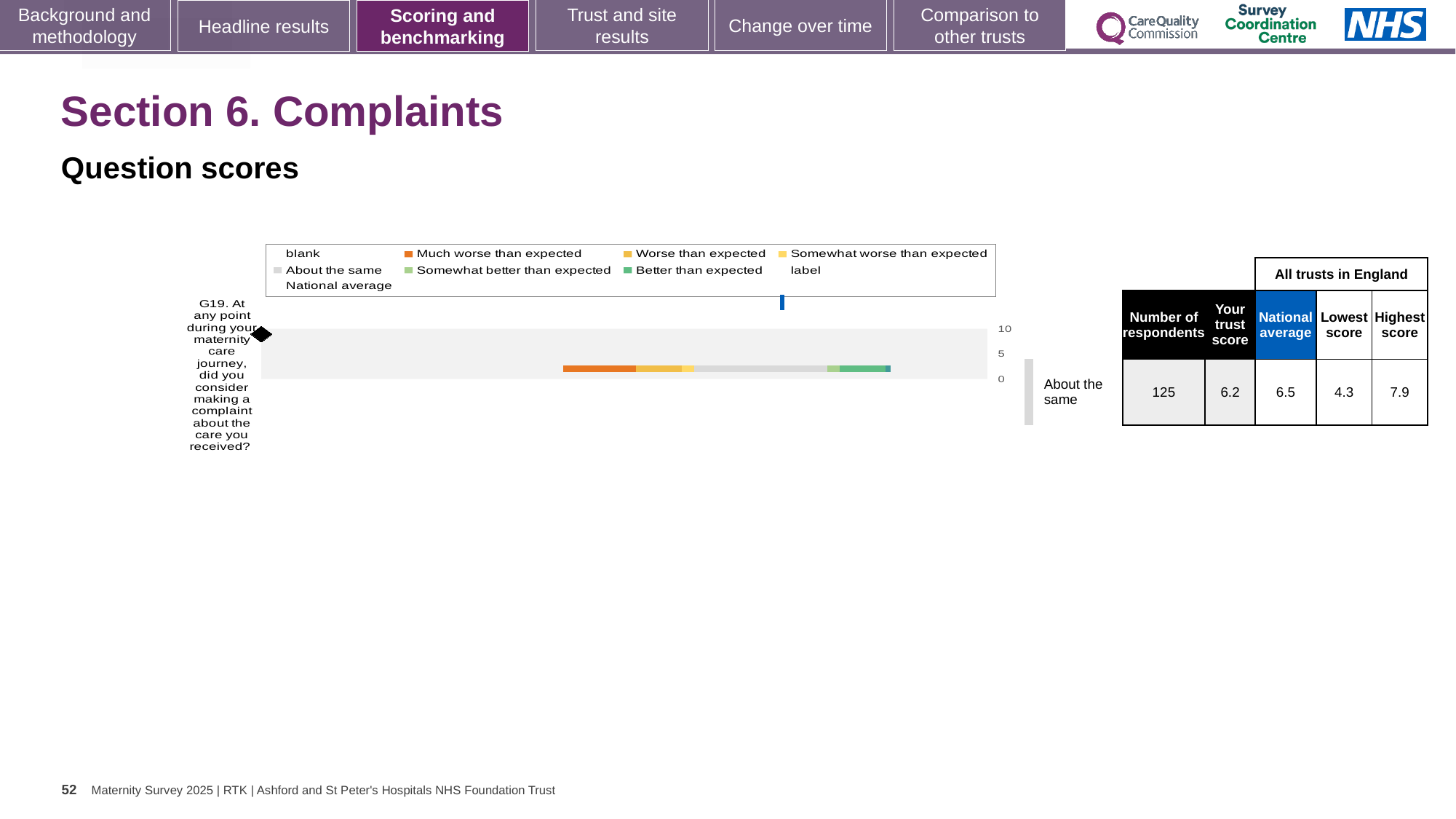
What is the highest score among all trusts in England for question G19? 7.9 Which legend entry is shown in orange? Much worse than expected What benchmark category is shown for question G19? About the same Which is larger for question G19, the trust score or the national average? National average What is the lowest score among all trusts in England for question G19? 4.3 What does the blue vertical line on the chart represent? National average What is the trust score for question G19? 6.2 How many questions are plotted on the chart? 1 What kind of chart is used to show the G19 question score? bar chart How many respondents answered question G19? 125 What is the national average score for question G19? 6.5 What is the difference between the highest and lowest scores for question G19? 3.6